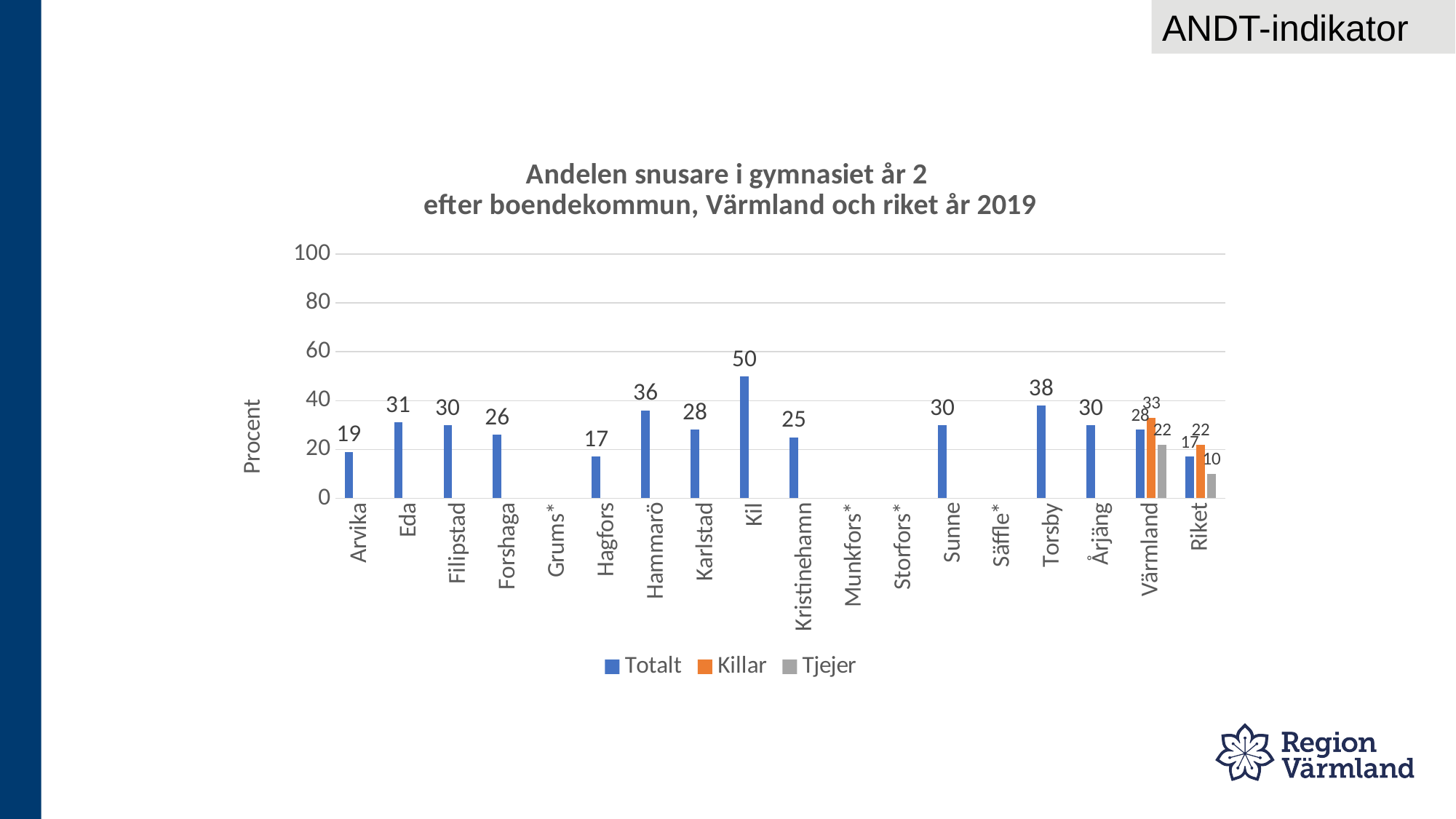
How many series does the legend list? 3 Is the Totalt value for Torsby greater or less than 40? less What is the Tjejer value for Riket? 10 What is the Totalt value for Kil? 50 What kind of chart is shown on the slide? bar chart Which municipality has the highest Totalt value? Kil What is the Killar value for Värmland? 33 What is the difference between the Totalt values for Kil and Hagfors? 33 How many categories are shown on the x axis? 18 What is the label of the y axis? Procent Which has a higher Totalt value, Hammarö or Karlstad? Hammarö Which category has the lowest Totalt value? Hagfors and Riket (both 17)